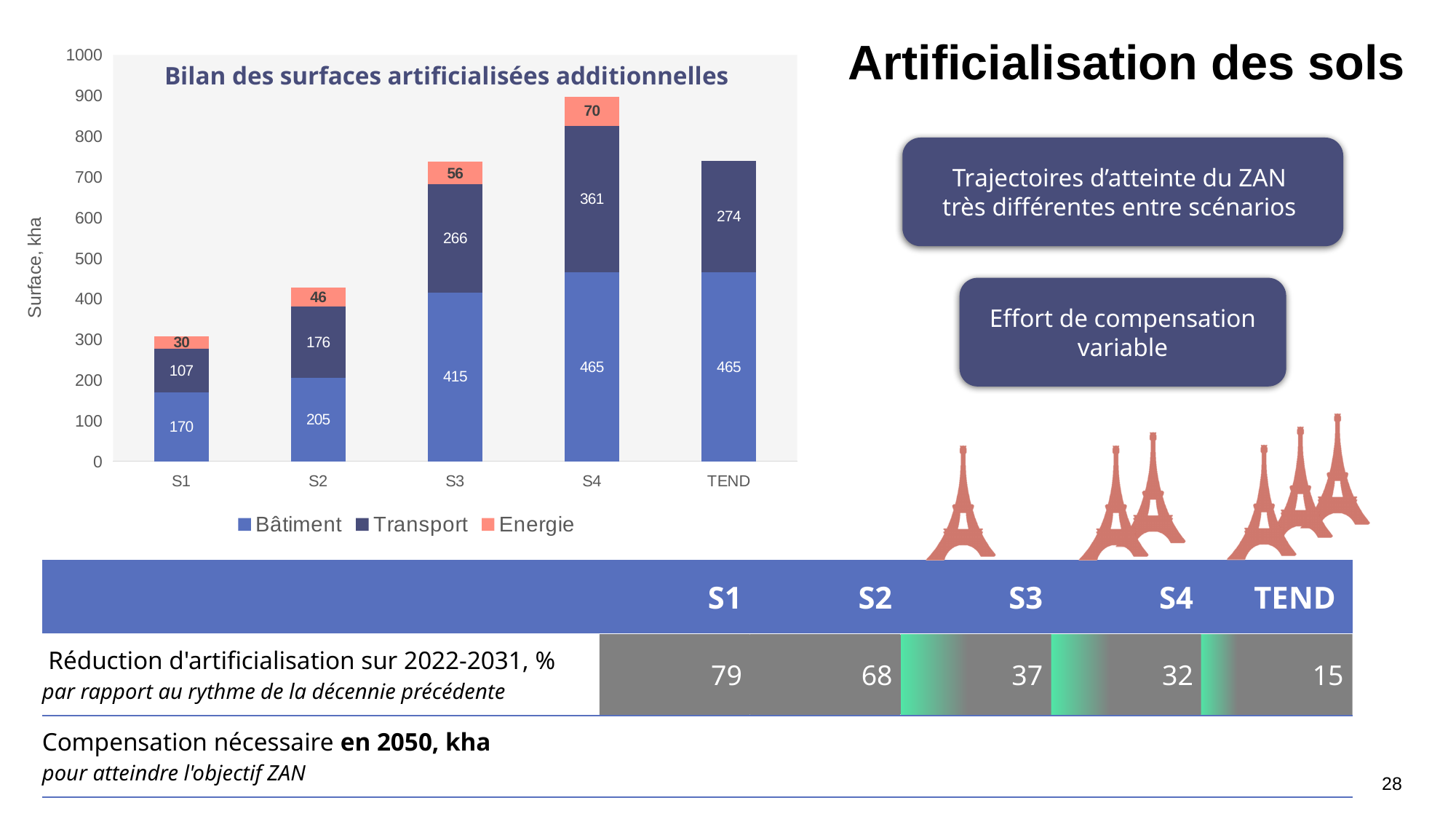
What is the total stacked value for S1 in the chart? 307 What is the Transport value for S4 in the chart? 361 What is the Bâtiment value for S3 in the chart? 415 What is the Energie value for S2 in the chart? 46 What is the title of the chart? Bilan des surfaces artificialisées additionnelles What is the difference between the Transport values for S4 and TEND? 87 Which scenario has the highest Transport value in the chart? S4 Is the Transport value for S2 larger or smaller than the Transport value for S3? smaller Which scenario has the lowest Bâtiment value in the chart? S1 How many scenario categories are shown on the x axis of the chart? 5 How many series does the chart legend list? 3 What type of chart is shown on the slide? stacked bar chart